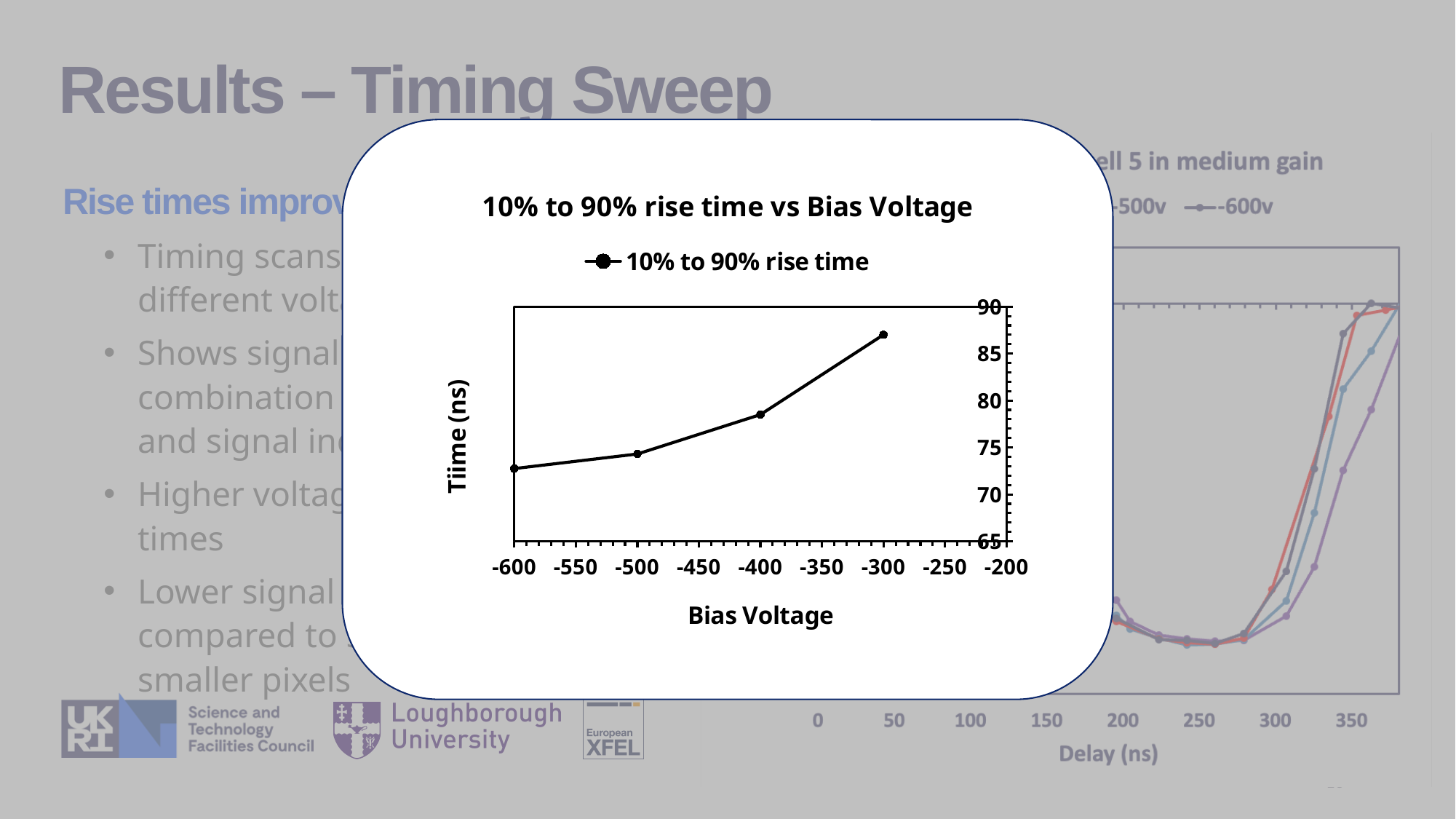
In the chart titled "10% to 90% rise time vs Bias Voltage", does the rise time rise or fall as the bias voltage goes from -600 to -300? rise In the chart titled "10% to 90% rise time vs Bias Voltage", what kind of chart is shown? line chart In the chart titled "10% to 90% rise time vs Bias Voltage", how many series does the legend list? 1 In the chart titled "10% to 90% rise time vs Bias Voltage", at which bias voltage is the rise time highest? -300 In the chart titled "10% to 90% rise time vs Bias Voltage", what is the x-axis title? Bias Voltage In the chart titled "10% to 90% rise time vs Bias Voltage", is the rise time at -300 greater or less than 85? greater In the chart titled "10% to 90% rise time vs Bias Voltage", which has the larger rise time, -500 or -400? -400 In the chart titled "10% to 90% rise time vs Bias Voltage", is the rise time at -400 greater or less than 75? greater In the chart titled "10% to 90% rise time vs Bias Voltage", is the rise time at -400 greater or less than 80? less In the chart titled "10% to 90% rise time vs Bias Voltage", what is the legend entry? 10% to 90% rise time In the chart titled "10% to 90% rise time vs Bias Voltage", how many data points are plotted? 4